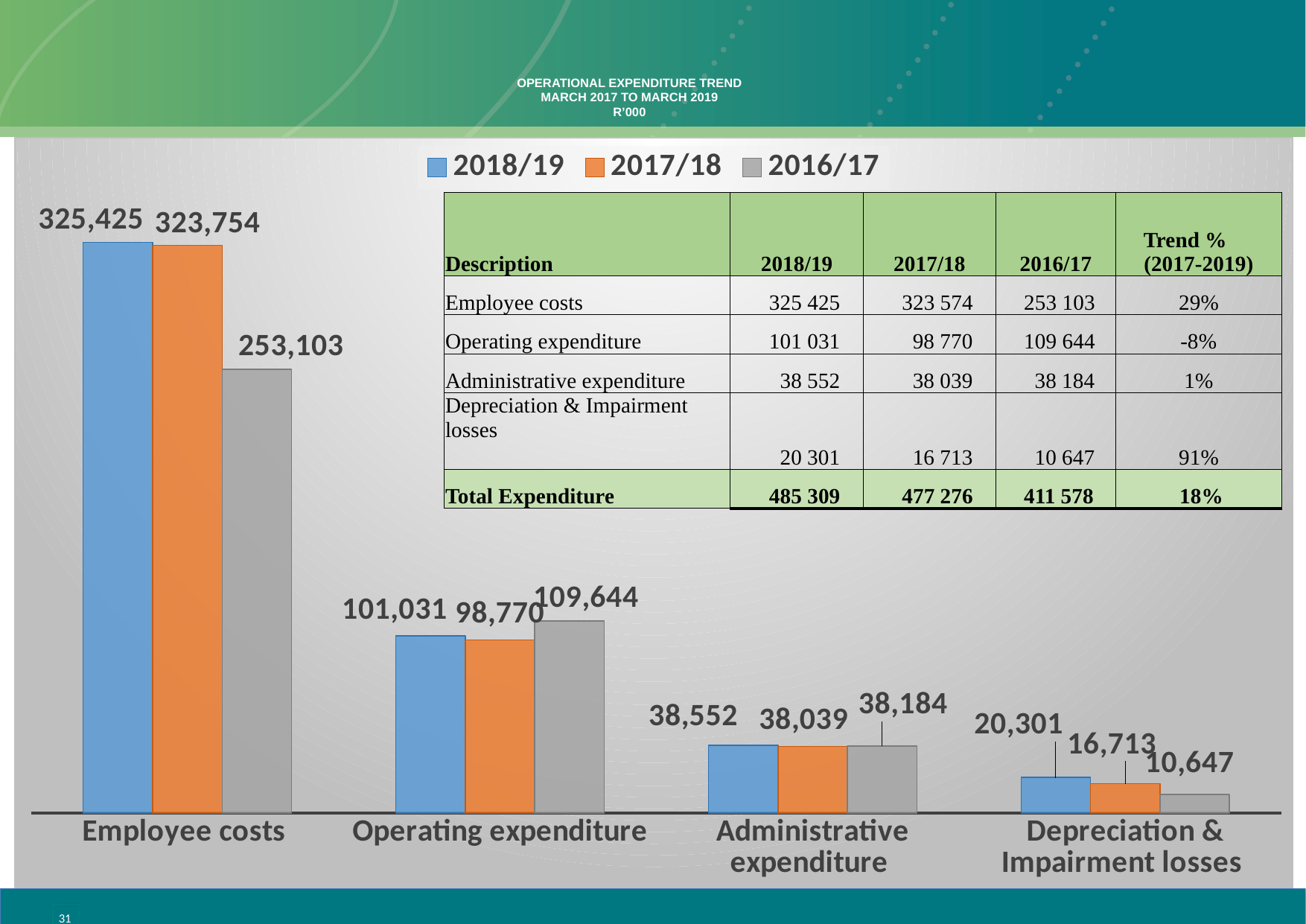
What is the value for Administrative expenditure in the 2018/19 series? 38,552 What is the value for Employee costs in the 2018/19 series? 325,425 Which category has the lowest value in the 2016/17 series? Depreciation & Impairment losses Which category has the highest value in the 2018/19 series? Employee costs What is the value for Depreciation & Impairment losses in the 2017/18 series? 16,713 Which colour represents the 2017/18 series in the chart? Orange What is the difference between the 2018/19 and 2016/17 values for Employee costs? 72,322 What is the value for Operating expenditure in the 2016/17 series? 109,644 What kind of chart is shown on the slide? Bar chart How many series does the chart legend list? 3 For Operating expenditure, which is larger: the 2018/19 value or the 2016/17 value? 2016/17 How many categories are shown on the x axis of the chart? 4